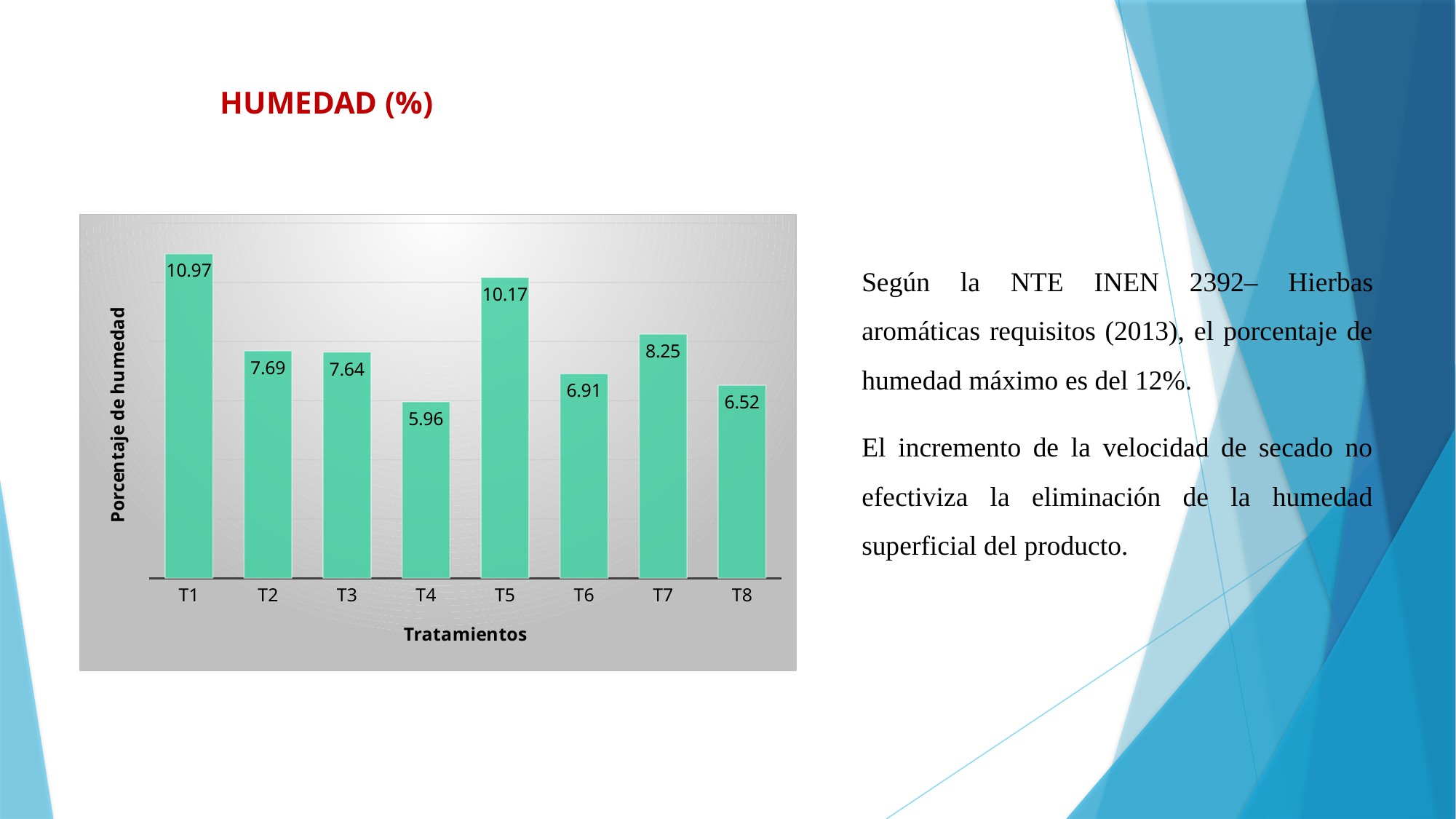
Which is larger, the value for T7 or the value for T6? T7 What is the value for T7? 8.25 Which treatment has the lowest value? T4 Which treatment has the highest value? T1 What is the title of the x axis? Tratamientos How many treatments are shown on the x axis? 8 What kind of chart is shown? Bar chart What is the value for T1? 10.97 What is the value for T5? 10.17 What is the difference between the values for T1 and T4? 5.01 What is the difference between the values for T5 and T6? 3.26 What is the value for T8? 6.52